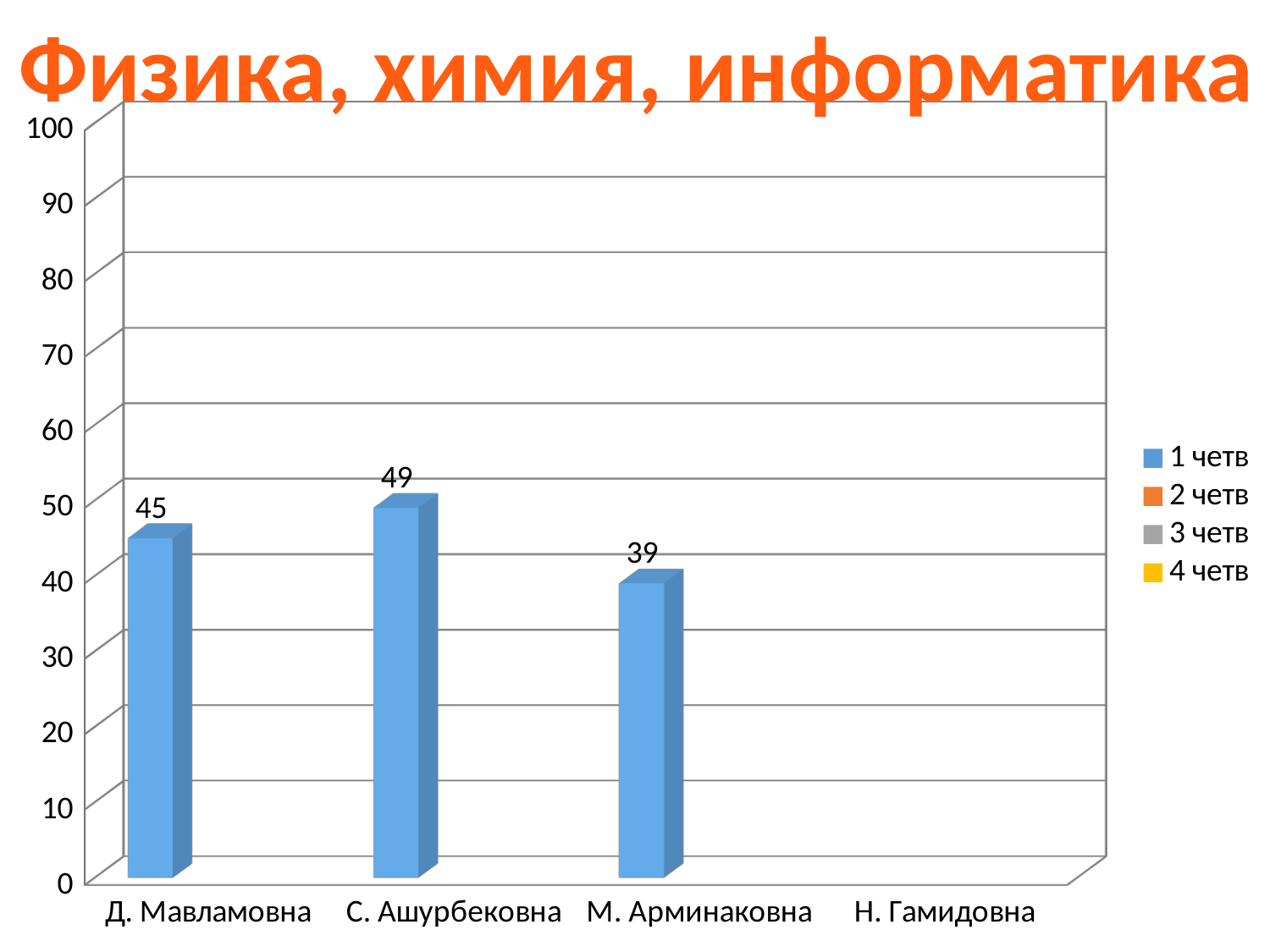
What is the difference between the values for С. Ашурбековна and Д. Мавламовна? 4 How many categories are shown on the x axis? 4 What is the value for М. Арминаковна in the 1 четв series? 39 What is the difference between the values for С. Ашурбековна and М. Арминаковна? 10 What kind of chart is shown on the slide? bar chart What is the value for Д. Мавламовна in the 1 четв series? 45 Which category has the highest value in the 1 четв series? С. Ашурбековна Which category with a plotted bar has the lowest value in the 1 четв series? М. Арминаковна Is the value for М. Арминаковна greater or less than 40? less Which is larger, the value for Д. Мавламовна or the value for М. Арминаковна? Д. Мавламовна What is the value for С. Ашурбековна in the 1 четв series? 49 How many series does the legend list? 4